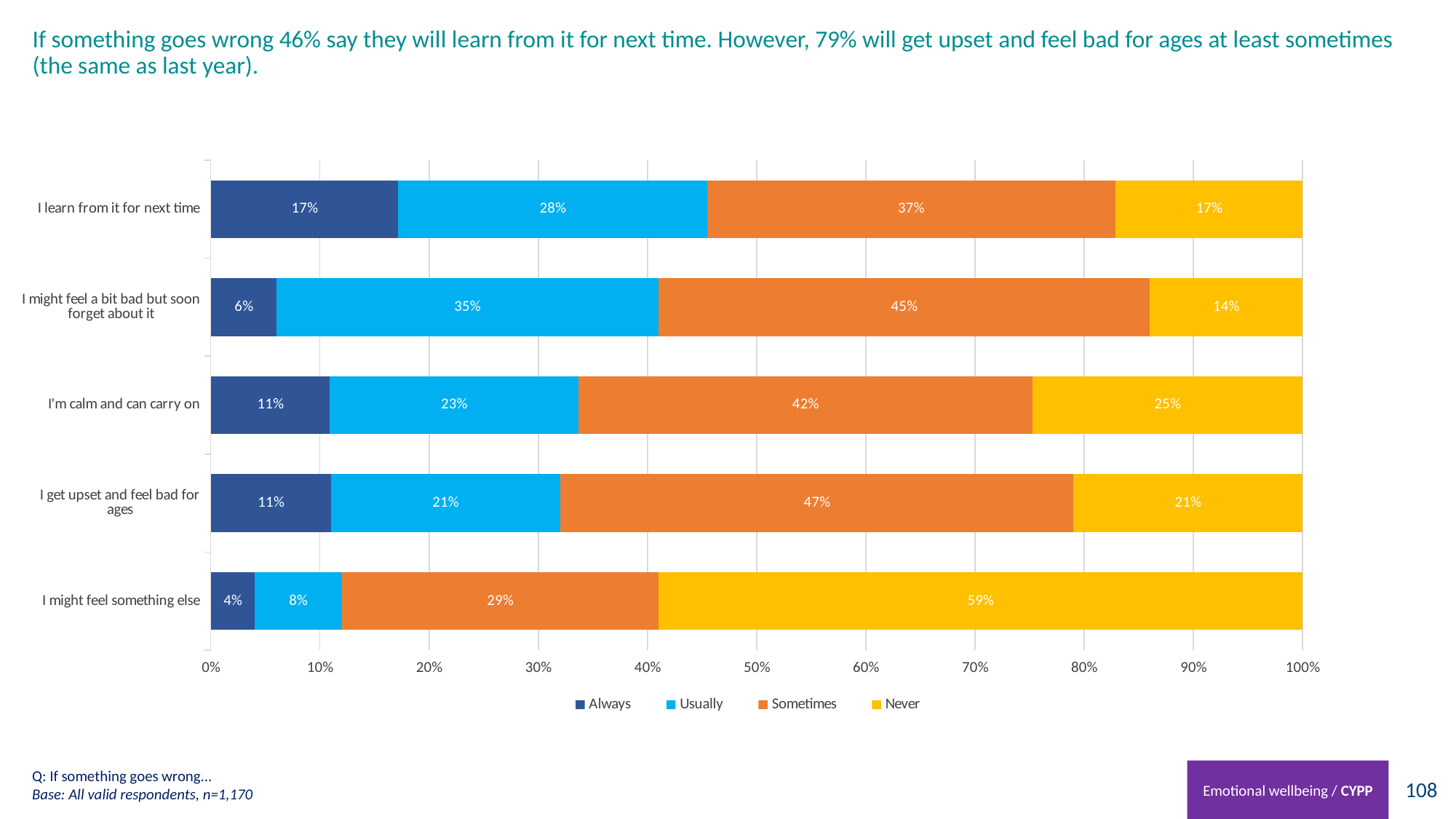
What is the 'Usually' value for 'I might feel a bit bad but soon forget about it'? 35% Which category has the highest 'Never' value? I might feel something else What is the 'Never' value for 'I might feel something else'? 59% What is the difference between the 'Sometimes' values for 'I get upset and feel bad for ages' and 'I learn from it for next time'? 10% Which is larger: the 'Usually' value for 'I'm calm and can carry on' or for 'I get upset and feel bad for ages'? I'm calm and can carry on How many series does the legend list? 4 What percentage say they 'Always' learn from it for next time? 17% What is the combined 'Always' and 'Usually' share for 'I learn from it for next time'? 45% What kind of chart is shown on the slide? Stacked bar chart Which category has the lowest 'Always' value? I might feel something else What is the 'Sometimes' value for 'I get upset and feel bad for ages'? 47% How many categories are shown on the chart? 5